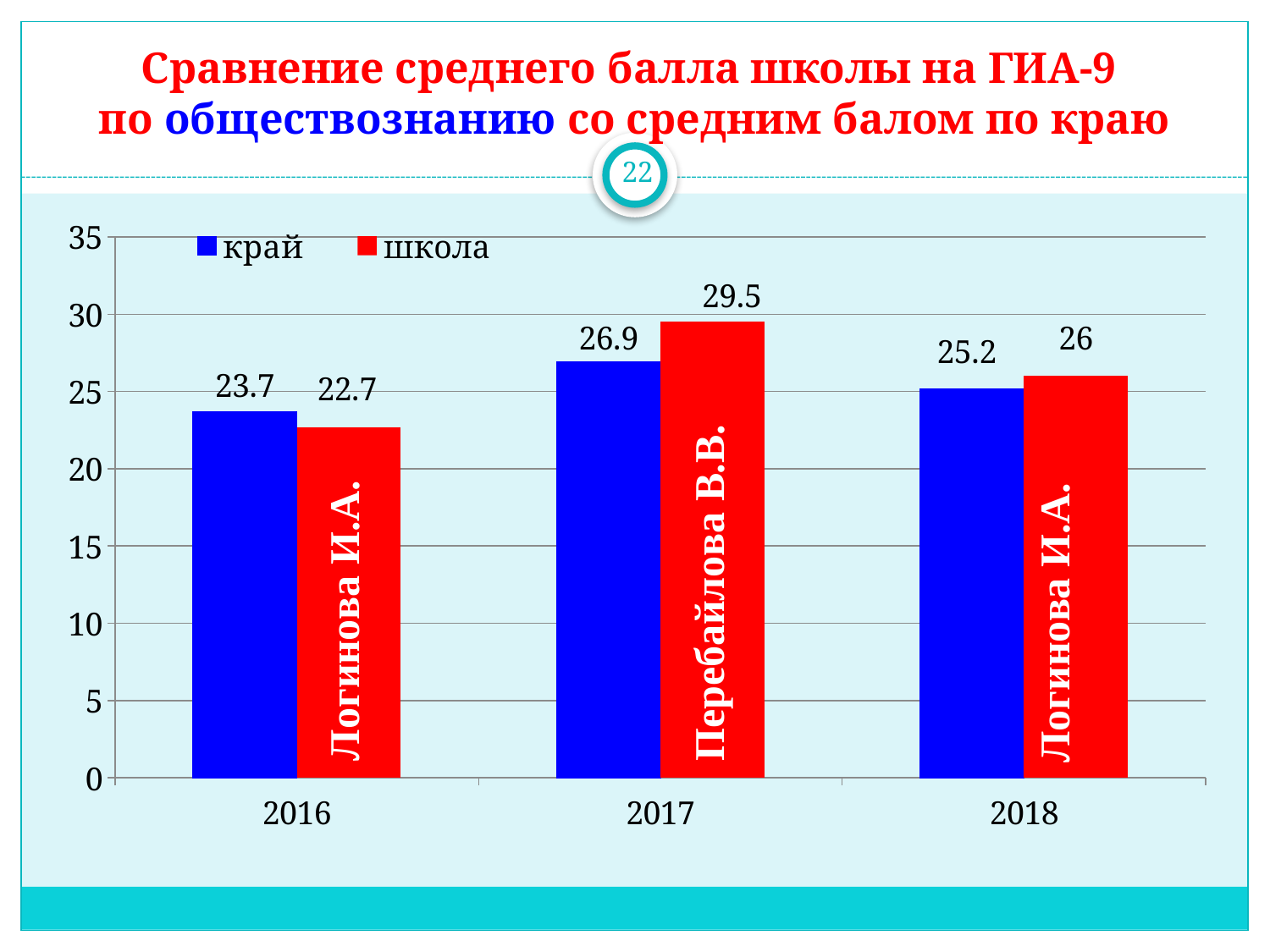
What is the difference between школа and край in 2017? 2.6 What kind of chart is this? bar chart Which is larger in 2016, край or школа? край In which year is the школа value highest? 2017 How many years are shown on the x axis? 3 What is the value for школа in 2018? 26 Which teacher's name is written on the школа bar for 2017? Перебайлова В.В. What is the value for край in 2016? 23.7 What is the value for школа in 2017? 29.5 How many series does the legend list? 2 What is the value for край in 2018? 25.2 In which year is the школа value lowest? 2016